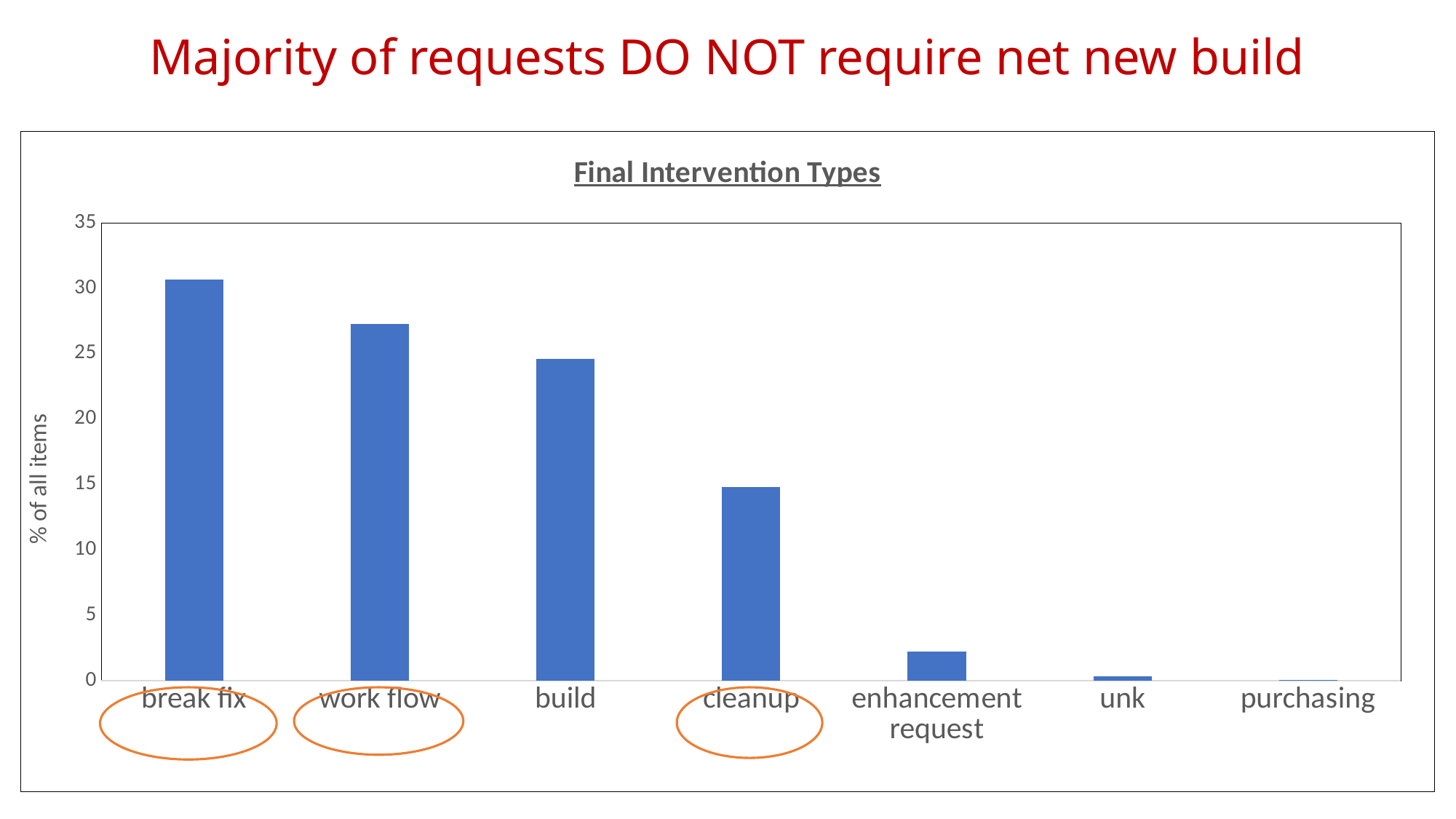
Is the value for work flow greater or less than 25? greater Which is larger, the value for work flow or the value for build? work flow Is the value for enhancement request greater or less than 5? less What is the label on the vertical axis of the chart? % of all items What type of chart is shown on the slide? bar chart Do the bar values rise or fall moving from left to right along the x axis? fall How many intervention type categories are shown on the x axis? 7 Which intervention type has the highest percentage of all items? break fix What is the title of the chart? Final Intervention Types Is the value for break fix greater or less than 30? greater